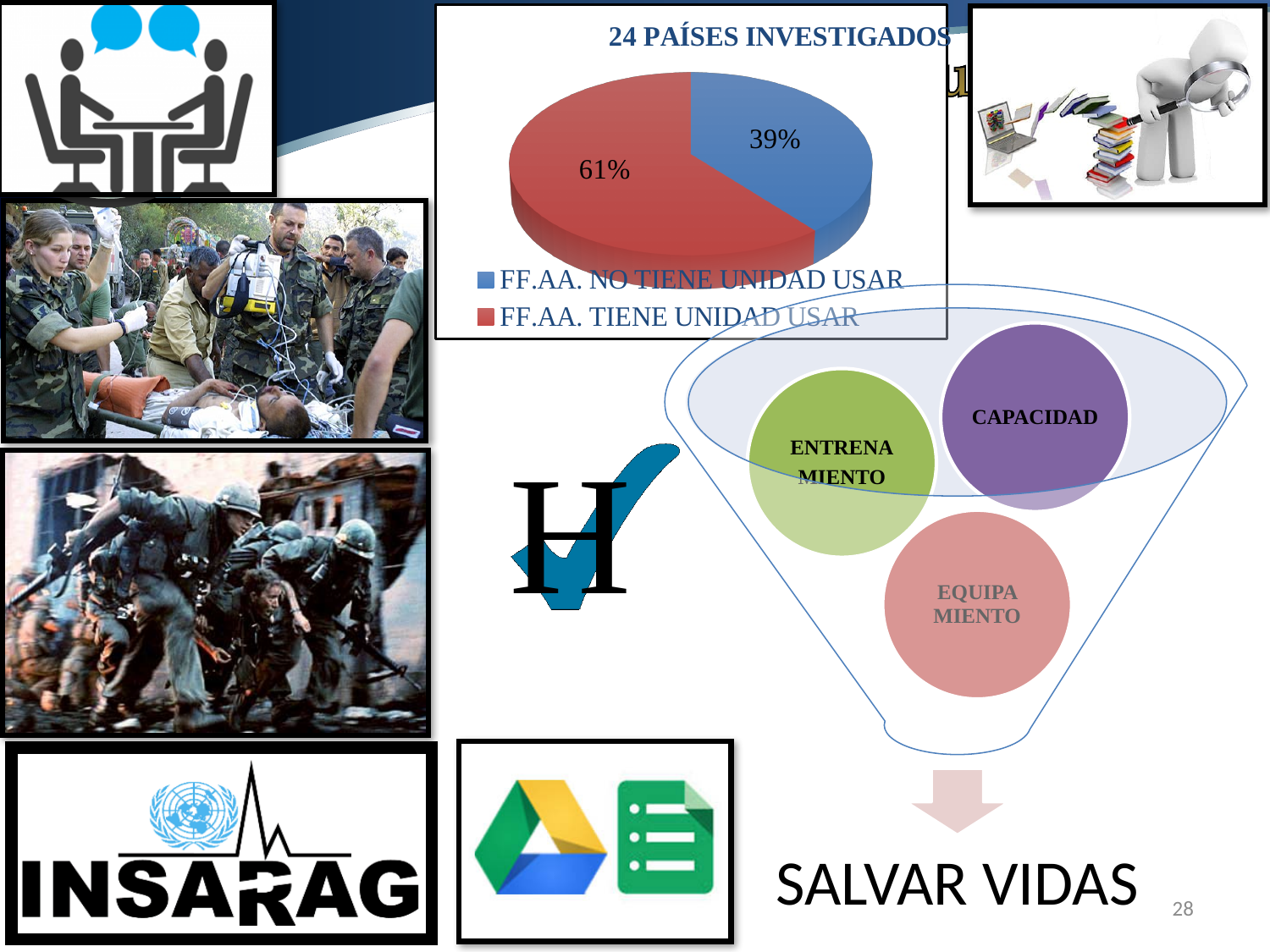
How many slices does the pie chart have? 2 What colour is the slice for FF.AA. NO TIENE UNIDAD USAR? blue What share of the pie does the red slice represent? 61% What percentage of the pie corresponds to FF.AA. NO TIENE UNIDAD USAR? 39% What kind of chart is shown on the slide? pie chart Which category has the smallest slice of the pie? FF.AA. NO TIENE UNIDAD USAR Which category has the largest slice of the pie? FF.AA. TIENE UNIDAD USAR Which is larger: the slice for FF.AA. TIENE UNIDAD USAR or the slice for FF.AA. NO TIENE UNIDAD USAR? FF.AA. TIENE UNIDAD USAR What is the title of the pie chart? 24 PAÍSES INVESTIGADOS What percentage of the pie corresponds to FF.AA. TIENE UNIDAD USAR? 61% What is the difference in percentage points between the FF.AA. TIENE UNIDAD USAR slice and the FF.AA. NO TIENE UNIDAD USAR slice? 22 How many entries does the legend of the pie chart list? 2